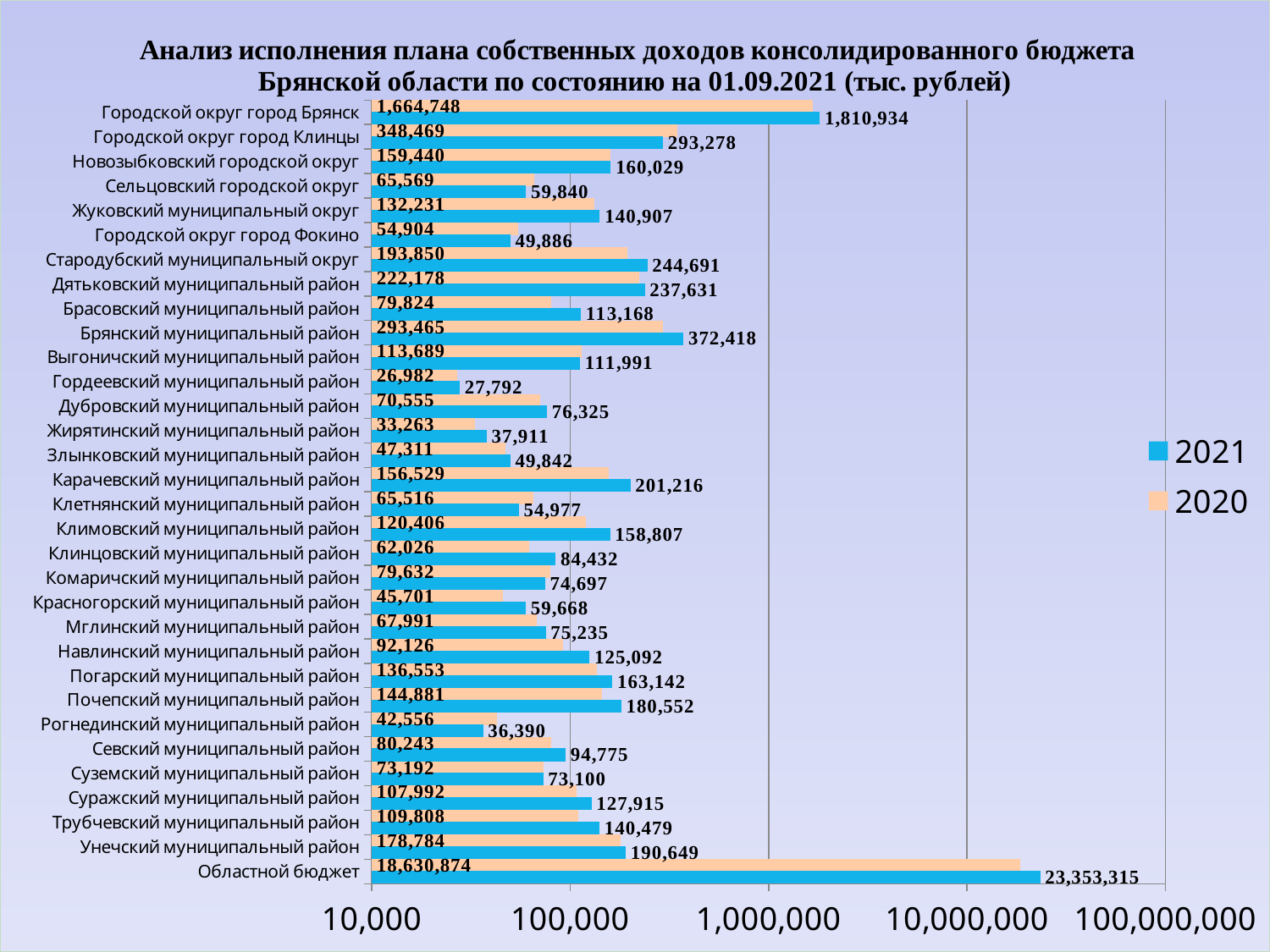
Which category has the highest 2021 value? Областной бюджет For Городской округ город Клинцы, which year has the larger value, 2020 or 2021? 2020 What is the 2021 value for Городской округ город Брянск? 1,810,934 How many categories are shown on the chart? 32 What is the difference between the 2021 and 2020 values for Городской округ город Брянск? 146,186 Which category has the lowest 2021 value? Гордеевский муниципальный район What is the 2021 value for Унечский муниципальный район? 190,649 What kind of chart is shown on the slide? Bar chart What is the 2020 value for Брянский муниципальный район? 293,465 How many series does the legend list? 2 What colour represents the 2021 series in the legend? Blue What is the difference between the 2021 and 2020 values for Областной бюджет? 4,722,441